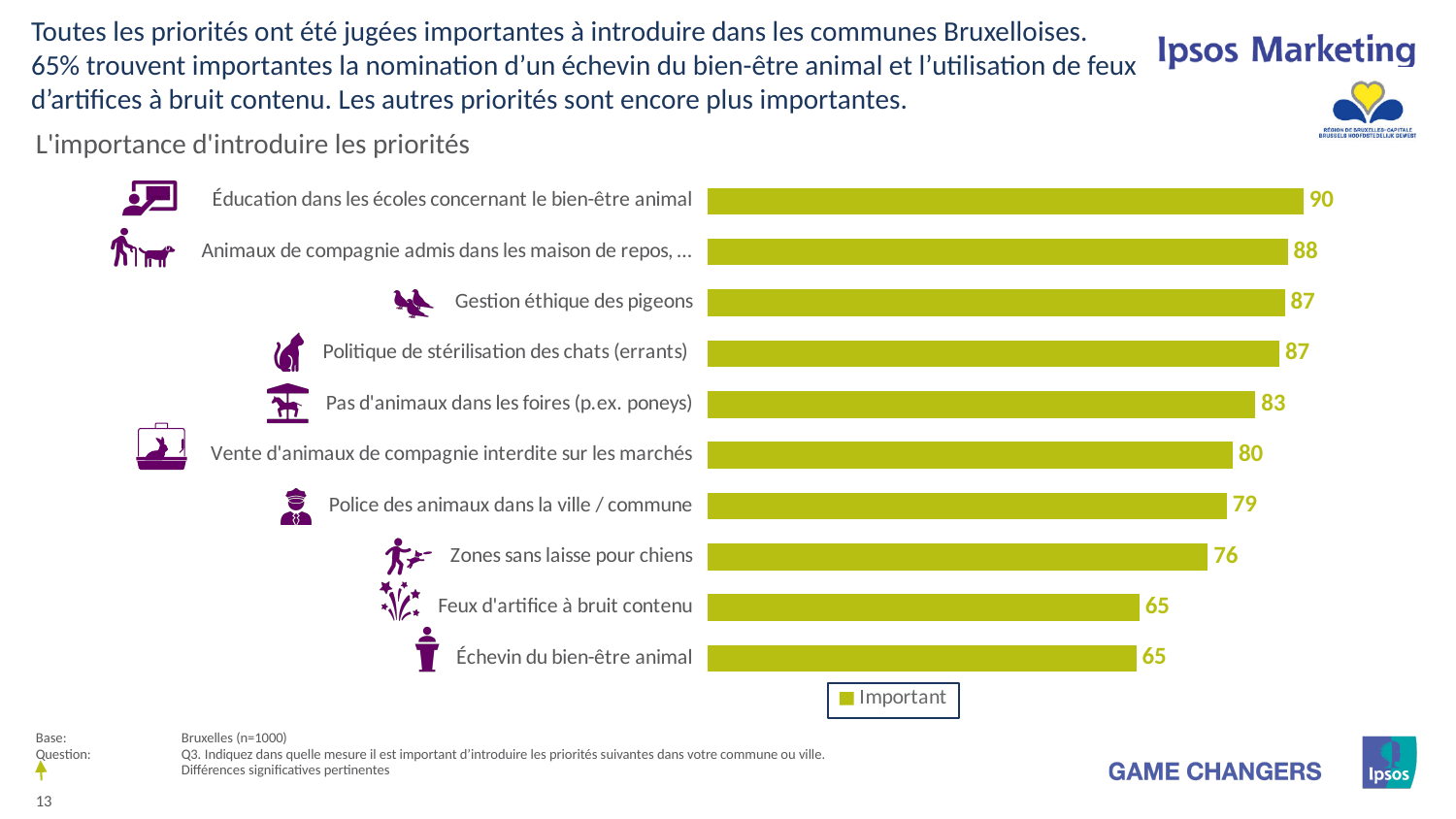
What is the value for "Gestion éthique des pigeons"? 87 What is the difference between the values for "Éducation dans les écoles concernant le bien-être animal" and "Échevin du bien-être animal"? 25 How many series does the legend list? 1 What kind of chart is shown on the slide? Bar chart What is the lowest value shown in the chart? 65 What is the name of the series shown in the legend? Important What is the difference between the values for "Pas d'animaux dans les foires (p.ex. poneys)" and "Vente d'animaux de compagnie interdite sur les marchés"? 3 How many categories are shown in the chart? 10 What is the value for "Zones sans laisse pour chiens"? 76 Which category has the highest value? Éducation dans les écoles concernant le bien-être animal What is the value for "Police des animaux dans la ville / commune"? 79 Which is larger: the value for "Zones sans laisse pour chiens" or the value for "Feux d'artifice à bruit contenu"? Zones sans laisse pour chiens